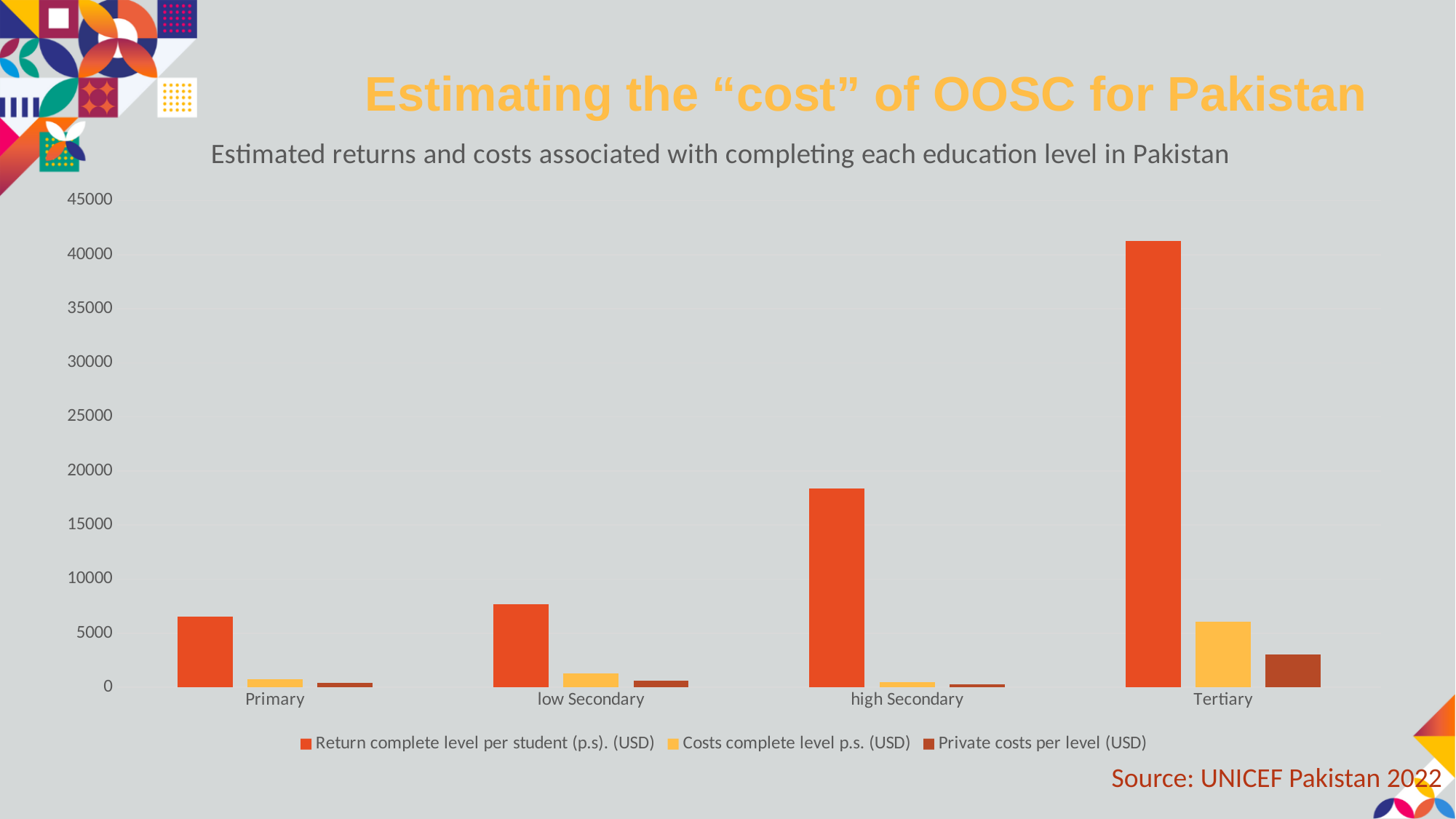
Which education level has the highest value for Return complete level per student (p.s.) (USD)? Tertiary What is the title of the chart? Estimated returns and costs associated with completing each education level in Pakistan Is the Return complete level per student value for Primary greater or less than 5000? greater How many series does the legend list? 3 Which education level has the highest value for Private costs per level (USD)? Tertiary What kind of chart is shown on the slide? Bar chart Which education level has the lowest value for Return complete level per student (p.s.) (USD)? Primary Which is larger: Costs complete level p.s. (USD) for Tertiary or for Primary? Tertiary Is the Return complete level per student value for high Secondary greater or less than 20000? less Do the Return complete level per student values rise or fall from Primary to Tertiary along the x axis? rise Is the Return complete level per student value for Tertiary greater or less than 35000? greater How many education levels are shown on the x axis? 4